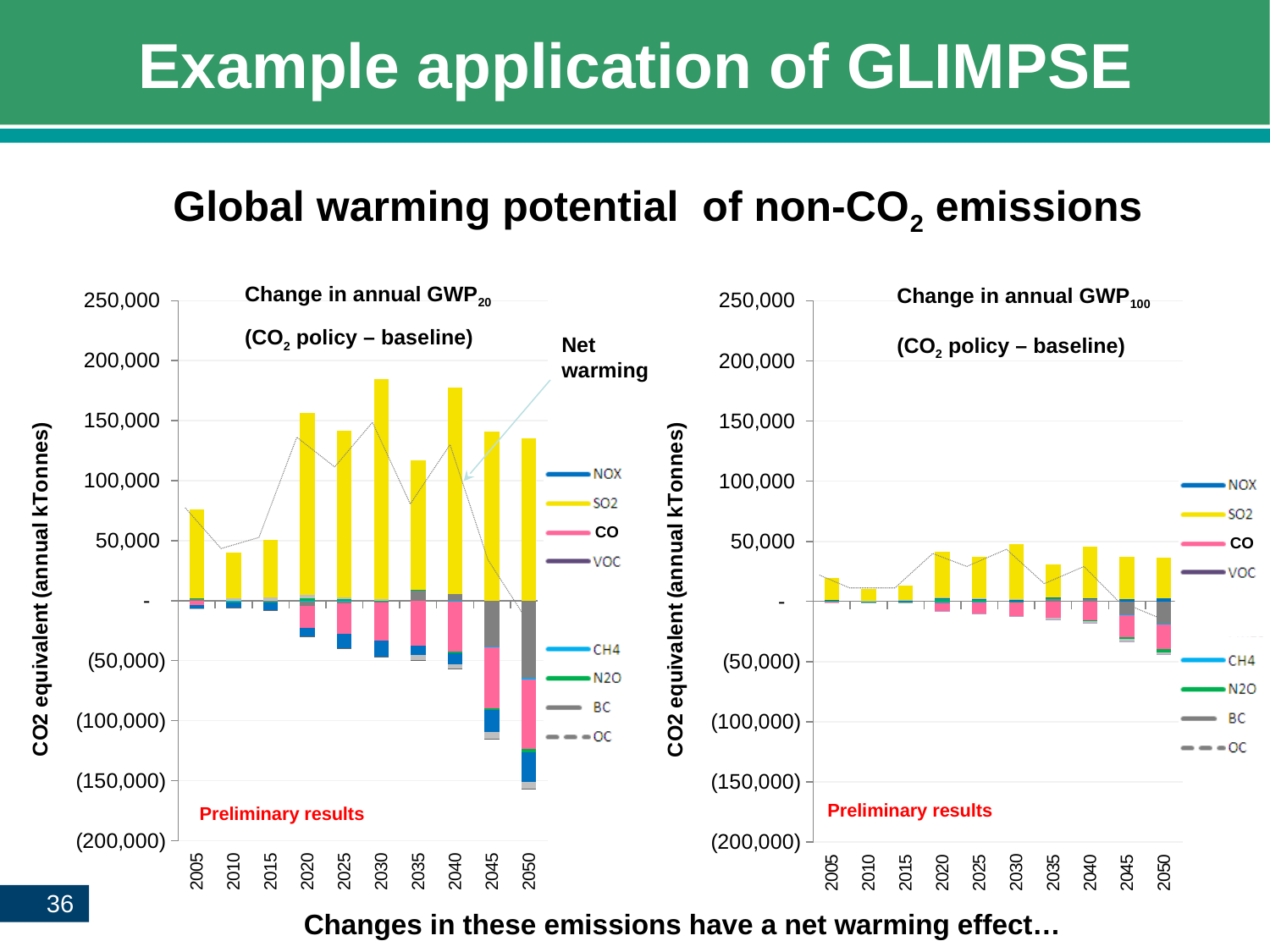
In the left chart, 'Change in annual GWP20', does the negative portion of the stacked bars generally grow or shrink from 2005 to 2050? grow In the right chart, 'Change in annual GWP100', which year has the stacked bar extending furthest below zero? 2050 In the right chart, 'Change in annual GWP100', is the SO2 value larger in 2040 or in 2010? 2040 In the right chart, 'Change in annual GWP100', is the SO2 value for 2020 greater or less than 50,000? less In the left chart, 'Change in annual GWP20', is the SO2 value for 2010 greater or less than 50,000? less How many years are shown on the x axis of the right chart, 'Change in annual GWP100'? 10 In the left chart, 'Change in annual GWP20', which year has the stacked bar extending furthest below zero? 2050 What type of chart is the left chart, 'Change in annual GWP20'? stacked bar chart In the left chart, 'Change in annual GWP20', is the SO2 value larger in 2020 or in 2010? 2020 What is the y-axis label of the left chart, 'Change in annual GWP20'? CO2 equivalent (annual kTonnes) In the left chart, 'Change in annual GWP20', is the SO2 value for 2030 greater or less than 150,000? greater How many series does the legend of the left chart, 'Change in annual GWP20', list? 8